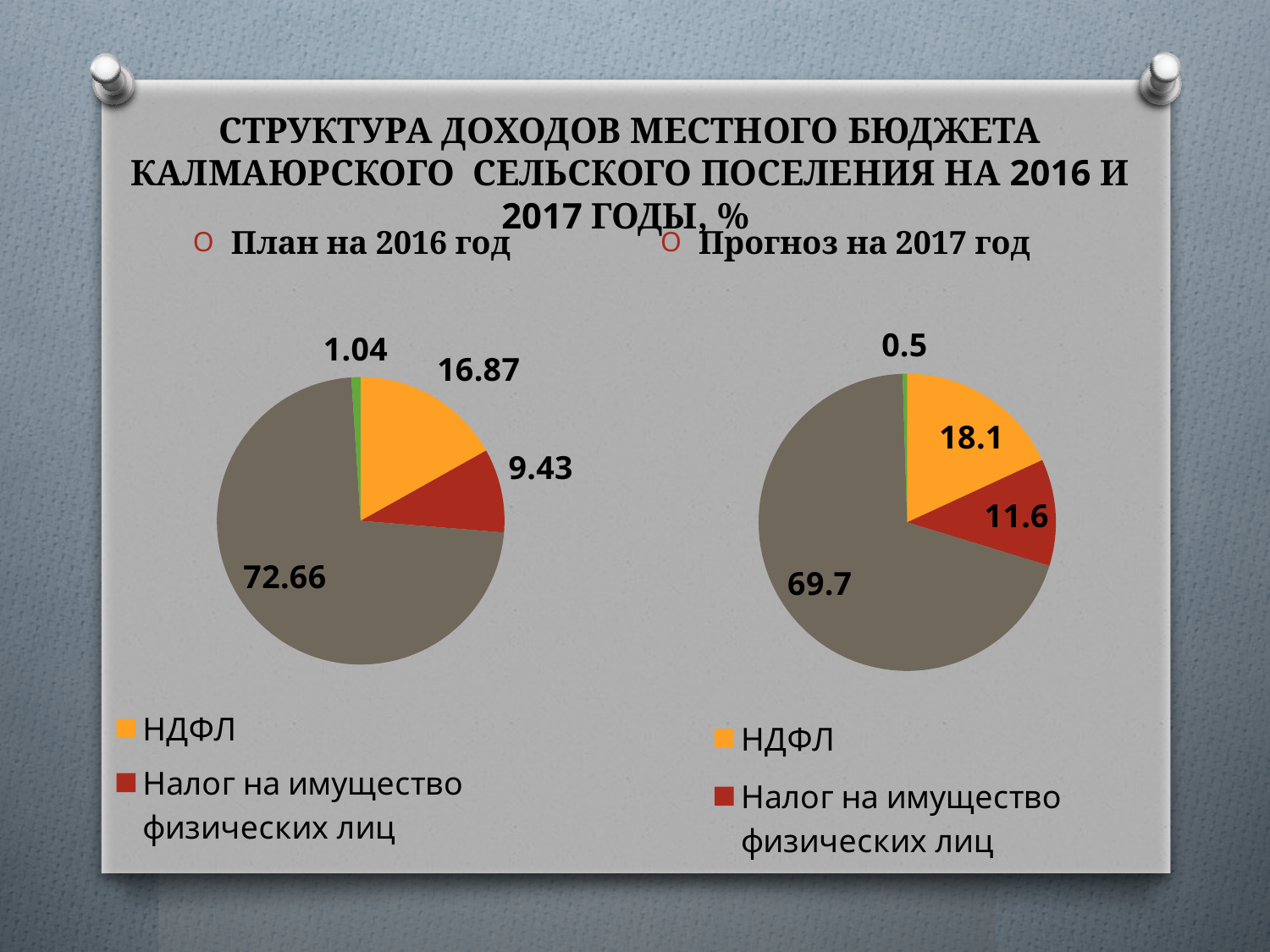
In the 'План на 2016 год' pie chart, what value is shown for НДФЛ? 16.87 In the 'План на 2016 год' pie chart, what value is shown for Налог на имущество физических лиц? 9.43 In the 'Прогноз на 2017 год' pie chart, what value is shown on the smallest slice? 0.5 In the 'План на 2016 год' pie chart, what is the difference between the НДФЛ value and the Налог на имущество физических лиц value? 7.44 What kind of chart is used for 'План на 2016 год'? pie chart In the 'Прогноз на 2017 год' pie chart, what value is shown for НДФЛ? 18.1 In the 'Прогноз на 2017 год' pie chart, which colour represents НДФЛ? orange In the 'Прогноз на 2017 год' pie chart, what is the difference between the НДФЛ value and the Налог на имущество физических лиц value? 6.5 Is the НДФЛ value larger in the 'План на 2016 год' chart or in the 'Прогноз на 2017 год' chart? Прогноз на 2017 год In the 'План на 2016 год' pie chart, what value is shown on the largest slice? 72.66 How many slices does the 'План на 2016 год' pie chart have? 4 In the 'Прогноз на 2017 год' pie chart, what value is shown for Налог на имущество физических лиц? 11.6